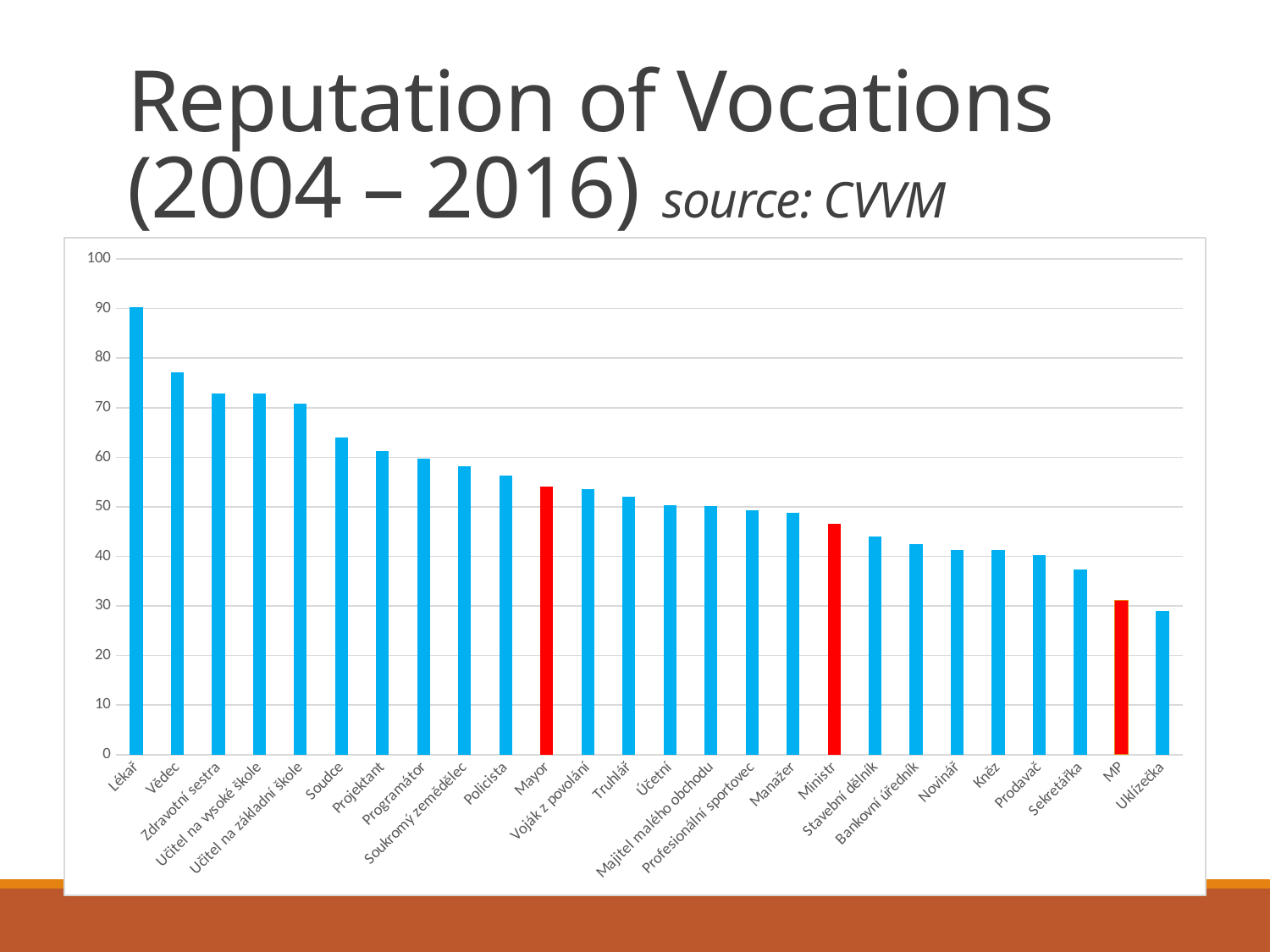
Is the value for Lékař greater or less than 80? greater What kind of chart is shown on the slide? bar chart Which has the larger value, Vědec or Zdravotní sestra? Vědec Is the value for Ministr greater or less than 50? less Which has the larger value, Mayor or Ministr? Mayor How many vocations are plotted in the chart? 26 Which vocation has the lowest reputation value in the chart? Uklízečka Which three vocations are shown with red bars? Mayor, Ministr, MP Is the value for Uklízečka greater or less than 30? less Do the values rise or fall moving from left to right along the x axis? fall Which vocation has the highest reputation value in the chart? Lékař